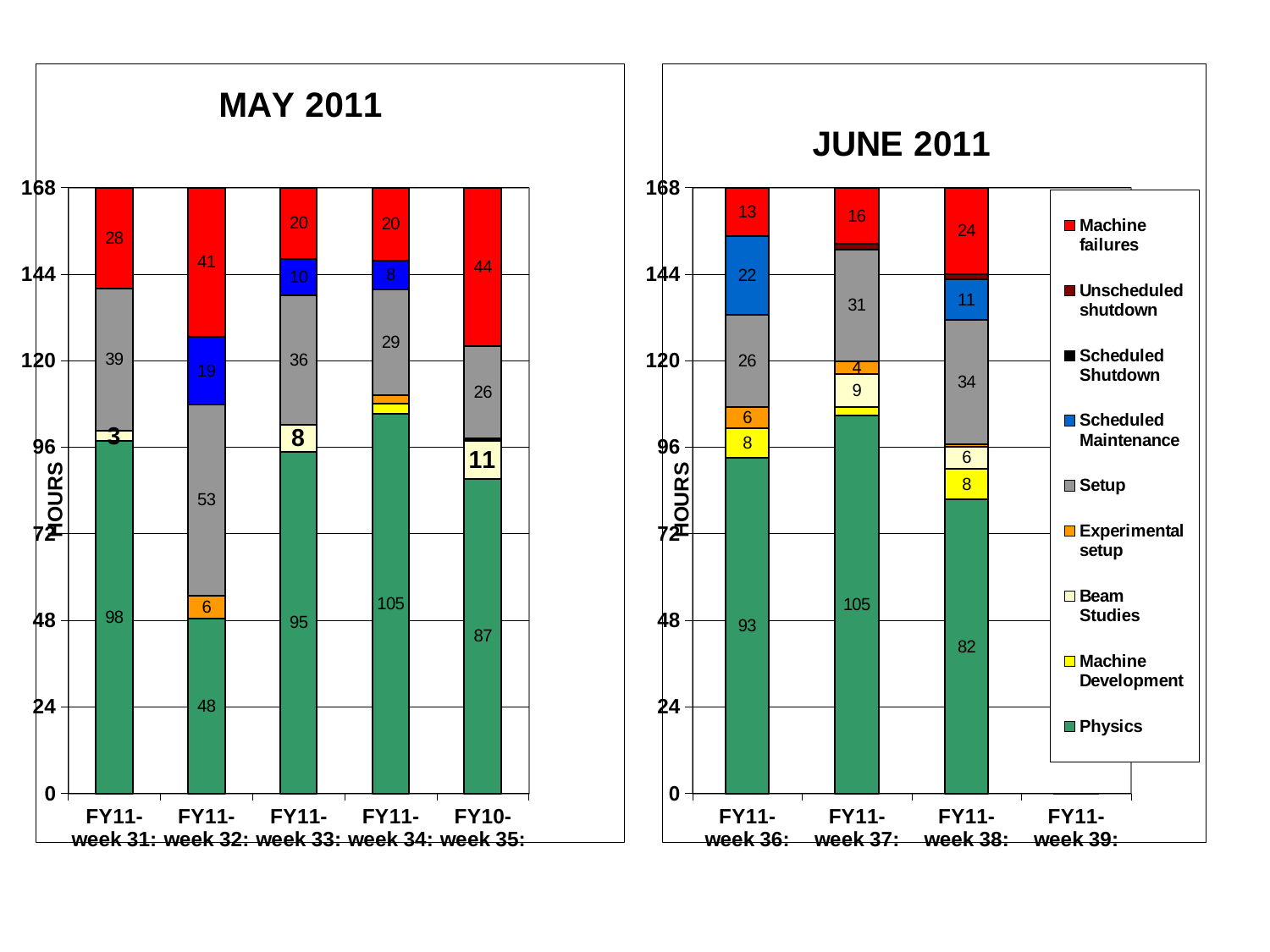
In the MAY 2011 chart, what is the Machine failures value for FY10-week 35? 44 In the JUNE 2011 chart, which week has the highest Setup value? FY11-week 38 In the JUNE 2011 chart, what is the Physics value for FY11-week 38? 82 In the MAY 2011 chart, which week has the lowest Physics value? FY11-week 32 What kind of chart is the JUNE 2011 chart? Stacked bar chart In the JUNE 2011 chart, which week has more Machine failures hours, FY11-week 36 or FY11-week 38? FY11-week 38 How many series does the legend of the JUNE 2011 chart list? 9 In the JUNE 2011 chart, what is the Scheduled Maintenance value for FY11-week 36? 22 In the MAY 2011 chart, how many hours of Physics are shown for FY11-week 34? 105 In the MAY 2011 chart, which week has the highest Physics value? FY11-week 34 How many weeks are shown on the x axis of the MAY 2011 chart? 5 In the MAY 2011 chart, what is the difference between the Setup hours for FY11-week 32 and FY10-week 35? 27